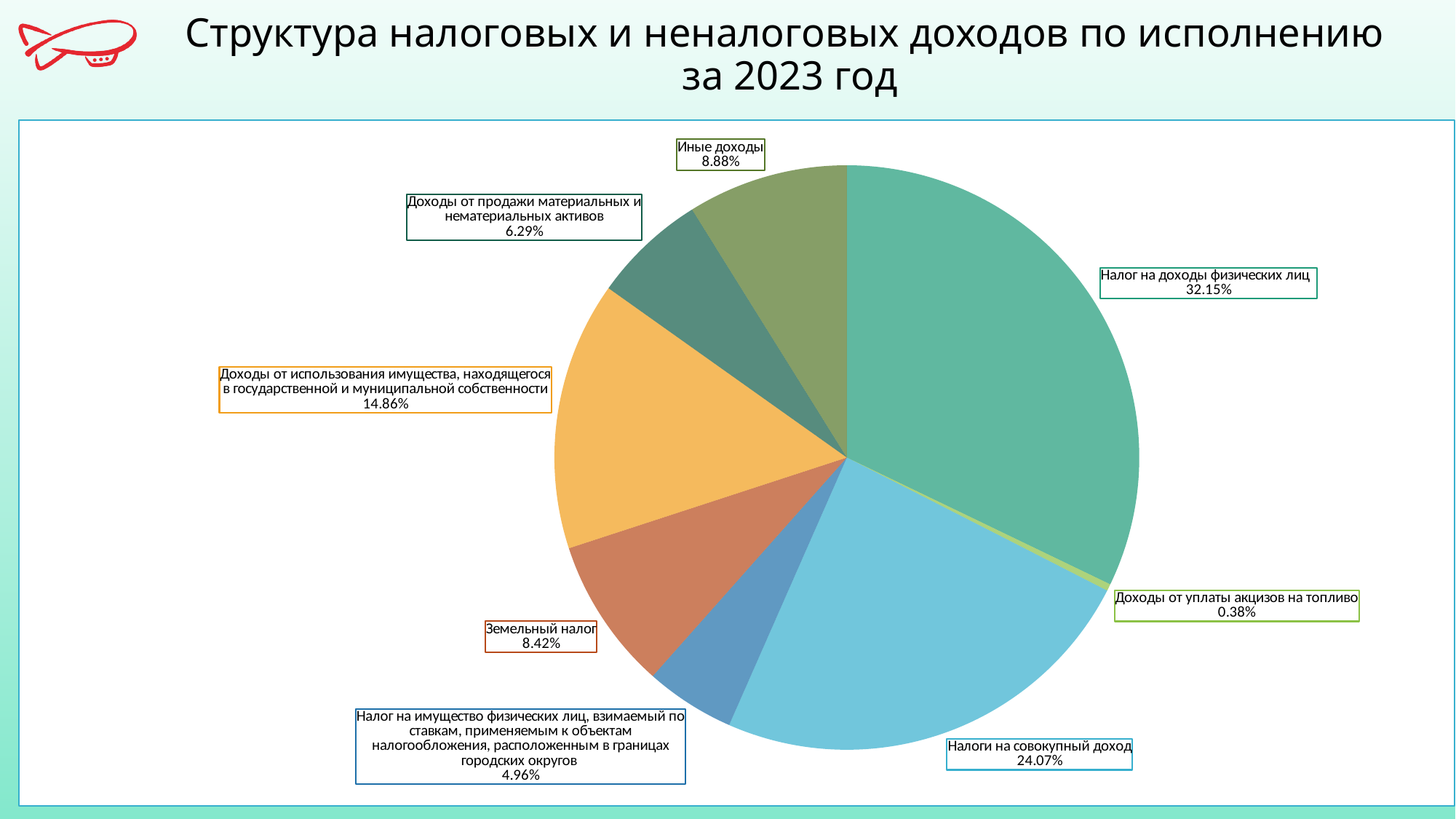
What is the value for "Доходы от уплаты акцизов на топливо"? 0.38% Which is larger: "Иные доходы" or "Доходы от продажи материальных и нематериальных активов"? Иные доходы What percentage is shown for "Земельный налог"? 8.42% What year does the slide title say the data is for? 2023 How many slices does the pie chart have? 8 What kind of chart is shown on the slide? pie chart What is the difference between the shares of "Налог на доходы физических лиц" and "Налоги на совокупный доход"? 8.08% What is the value shown for "Налоги на совокупный доход"? 24.07% What share of the pie is "Доходы от использования имущества, находящегося в государственной и муниципальной собственности"? 14.86% Which category has the smallest share of the pie? Доходы от уплаты акцизов на топливо Which category has the largest share of the pie? Налог на доходы физических лиц What share of the pie is "Налог на доходы физических лиц"? 32.15%